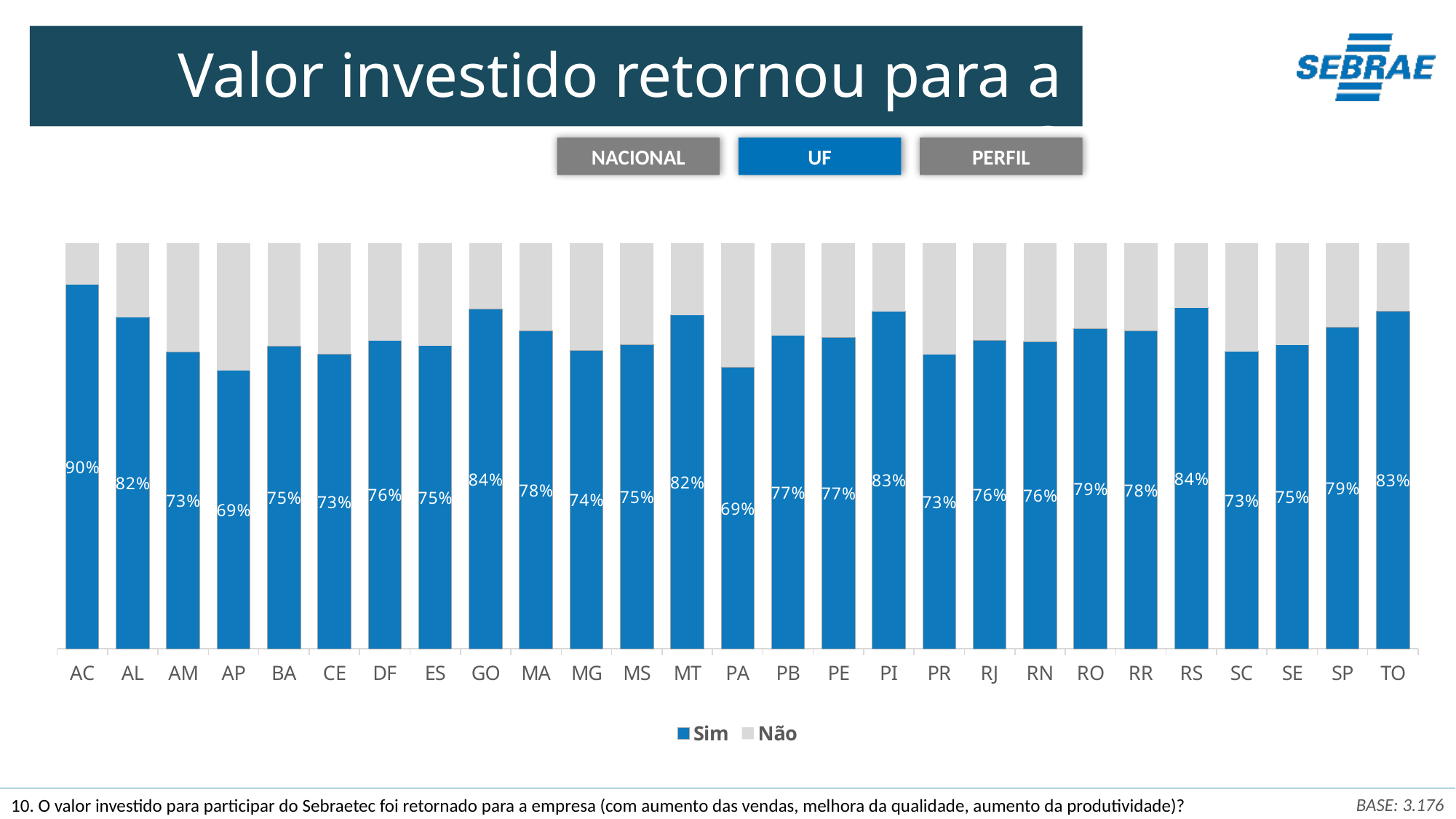
What is the "Sim" value for RS? 84% Which state has the highest "Sim" value? AC What is the "Sim" value for AC? 90% What is the difference between the "Sim" values for GO and MG? 10 percentage points What is the "Sim" value for PA? 69% Which has a larger "Sim" value, MT or SC? MT What is the difference between the "Sim" values for AC and AP? 21 percentage points What kind of chart is shown on the slide? Stacked bar chart Which has a larger "Sim" value, PI or PR? PI What is the "Sim" value for SP? 79% How many states (categories) are shown on the x axis? 27 How many series does the legend list? 2